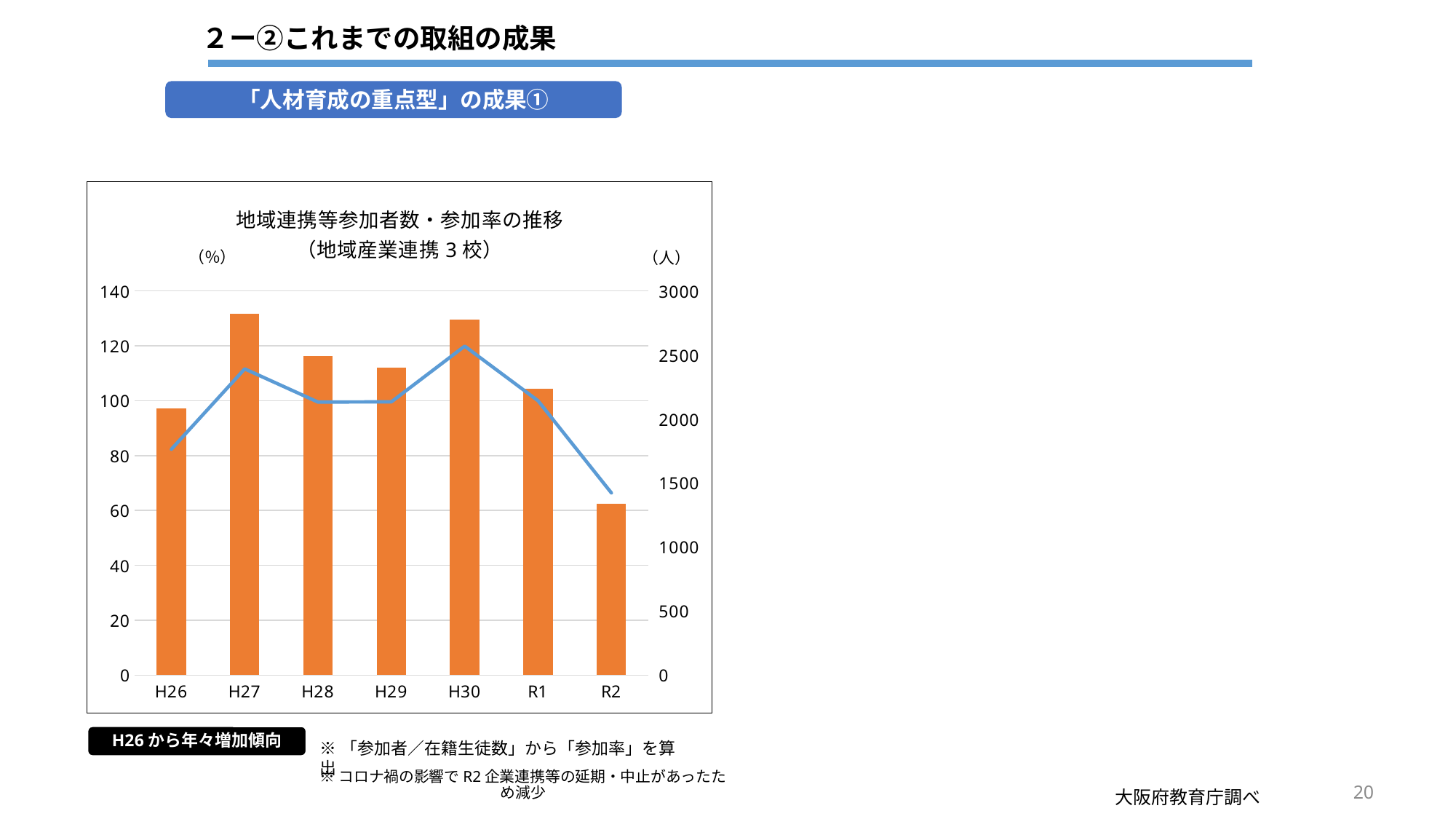
Is the bar value for H27 greater or less than 2500 on the right axis? greater Is the line value for H30 greater or less than 100 on the left axis? greater What unit is shown on the right-hand axis of the chart? （人） Is the bar value for R2 greater or less than 1500 on the right axis? less In which year does the line reach its lowest point? R2 In which year does the line reach its highest point? H30 What is the title of the chart? 地域連携等参加者数・参加率の推移（地域産業連携3校） Which year has the lowest bar in the chart? R2 Which year has the taller bar, H30 or R1? H30 How many categories (years) are shown on the x axis of the chart? 7 What kind of chart is shown on the slide? A combined bar and line chart Does the line rise or fall from R1 to R2? Fall